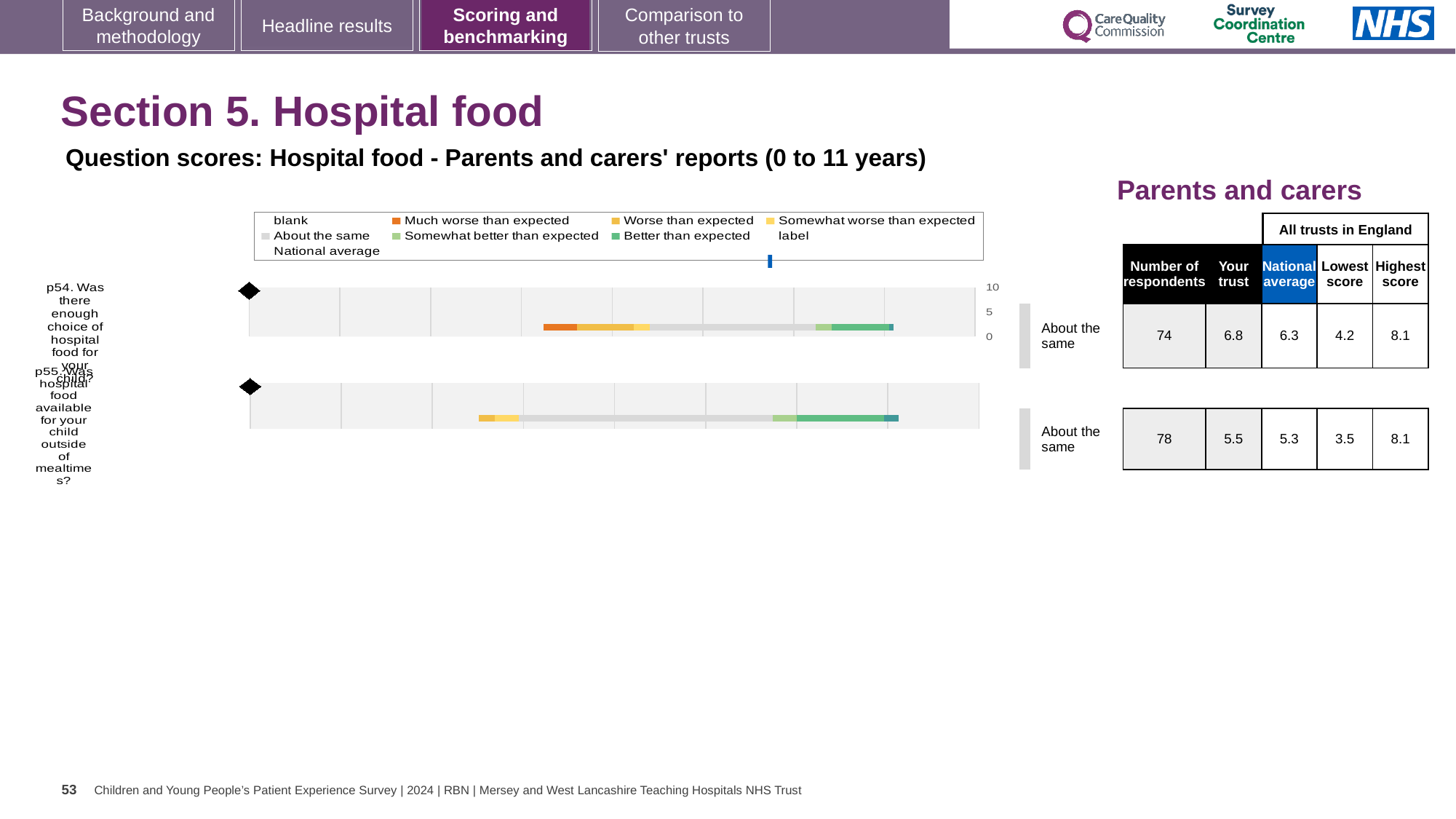
How many entries does the legend of the hospital food chart list? 9 What is the 'Your trust' score for p54 (enough choice of hospital food for your child)? 6.8 Which question has the higher 'Your trust' score, p54 or p55? p54 What kind of chart is used to show the question scores for hospital food? bar chart How many respondents answered p54 (enough choice of hospital food)? 74 What is the difference between the highest score and the lowest score across all trusts in England for p55? 4.6 What is the national average score for p55 (hospital food available outside of mealtimes)? 5.3 How many questions (categories) are plotted in the hospital food chart? 2 What is the highest score among all trusts in England for p54? 8.1 In the legend of the hospital food chart, what colour represents 'Much worse than expected'? orange What is the title above the hospital food chart? Question scores: Hospital food - Parents and carers' reports (0 to 11 years) What benchmark category is shown for p55 (hospital food available outside of mealtimes)? About the same